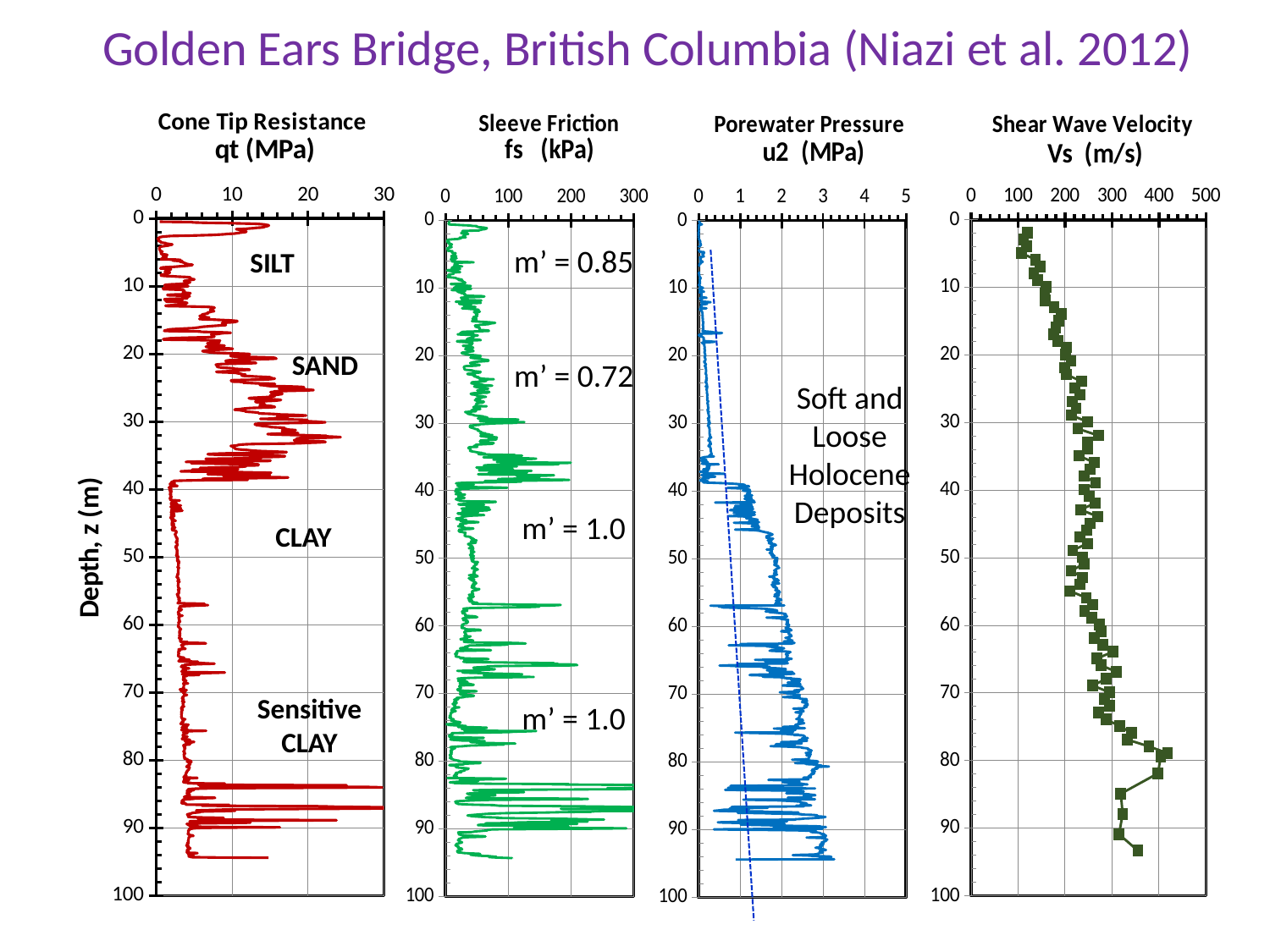
In the Cone Tip Resistance chart, is the value at a depth of 30 m greater or less than 10 MPa? greater In the Porewater Pressure chart, is the value at a depth of 70 m greater or less than 1 MPa? greater What unit is used on the x axis of the Shear Wave Velocity chart? m/s In the Shear Wave Velocity chart, does the velocity generally increase or decrease with depth between 0 m and 80 m? increase What kind of chart is the Cone Tip Resistance chart? line chart In the Shear Wave Velocity chart, is the value at a depth of 10 m greater or less than 200 m/s? less What is the maximum value shown on the x axis of the Porewater Pressure chart? 5 In the Shear Wave Velocity chart, which is larger: the velocity at a depth of 10 m or at a depth of 80 m? 80 m How many charts are shown on the slide? 4